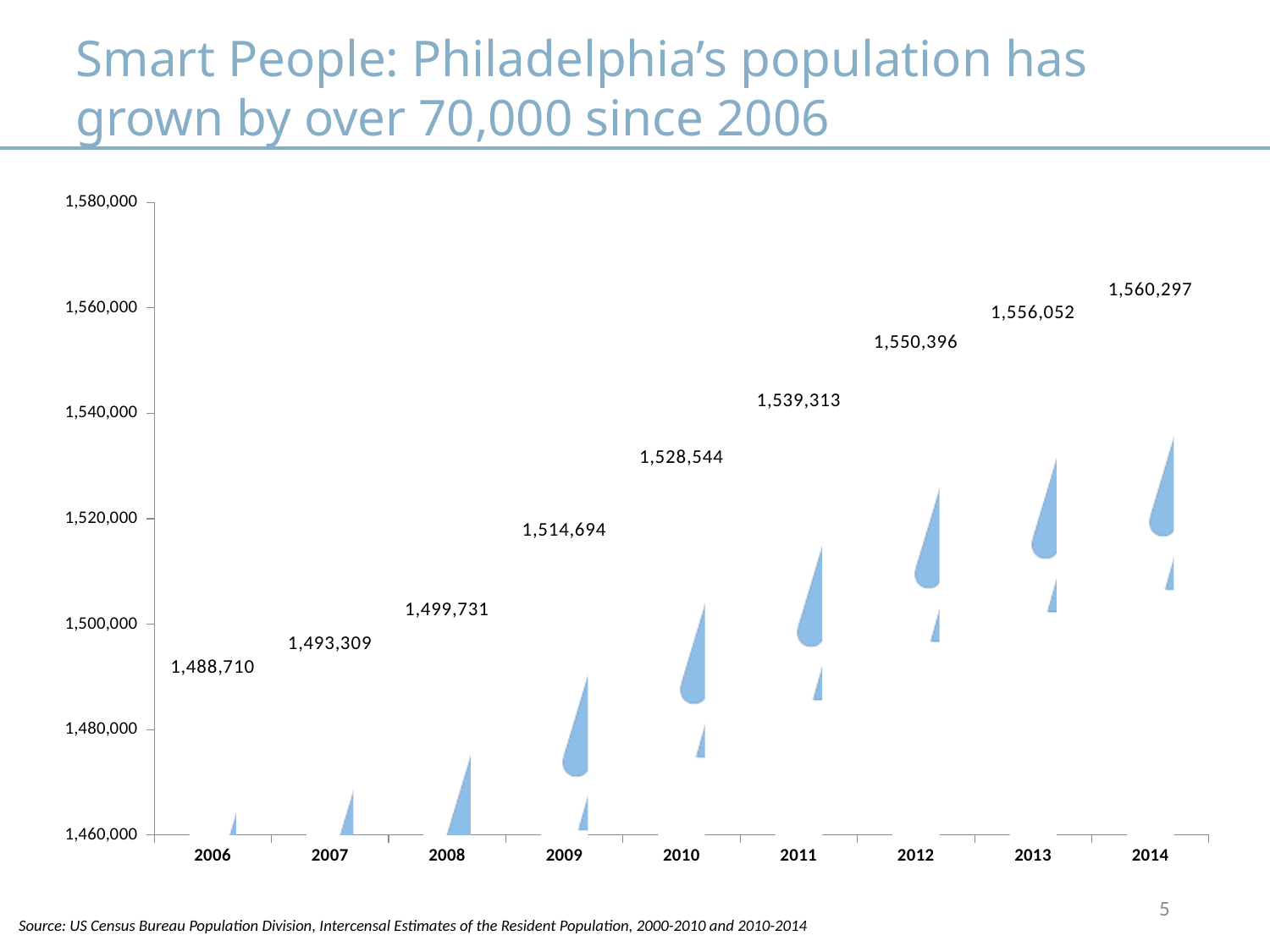
Which is larger, the value for 2011 or the value for 2013? 2013 By how much did the population grow from 2006 to 2014? 71,587 What value is shown for 2012? 1,550,396 Which year has the highest population value? 2014 What kind of chart is this? Bar chart How many years are shown on the x axis? 9 What was Philadelphia's population in 2006? 1,488,710 What was Philadelphia's population in 2010? 1,528,544 Do the values rise or fall from 2006 to 2014? Rise What was Philadelphia's population in 2014? 1,560,297 What is the difference between the 2010 and 2009 values? 13,850 Which year has the lowest population value? 2006